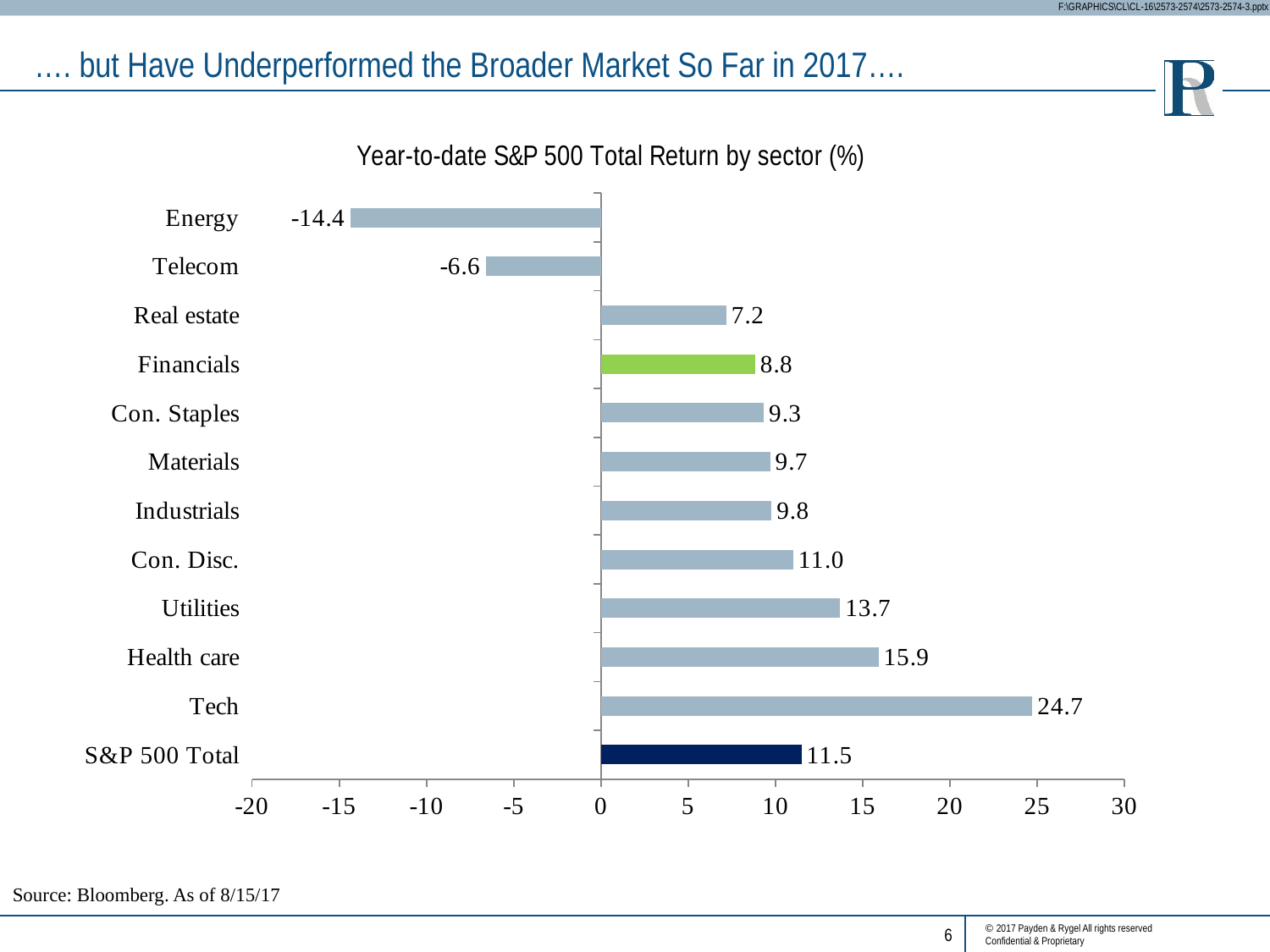
What is the difference between the Tech return and the S&P 500 Total return? 13.2 Which sector has the lowest year-to-date total return? Energy Which has a higher year-to-date return, Real estate or Con. Disc.? Con. Disc. Which sector has the highest year-to-date total return? Tech What is the year-to-date total return for the S&P 500 Total? 11.5 Which has a higher year-to-date return, Financials or the S&P 500 Total? S&P 500 Total What is the year-to-date total return for Energy? -14.4 How many bars are plotted in the chart? 12 What is the title of the chart? Year-to-date S&P 500 Total Return by sector (%) What kind of chart is shown on the slide? Bar chart What is the year-to-date total return for Financials? 8.8 What is the difference between the Health care return and the Utilities return? 2.2